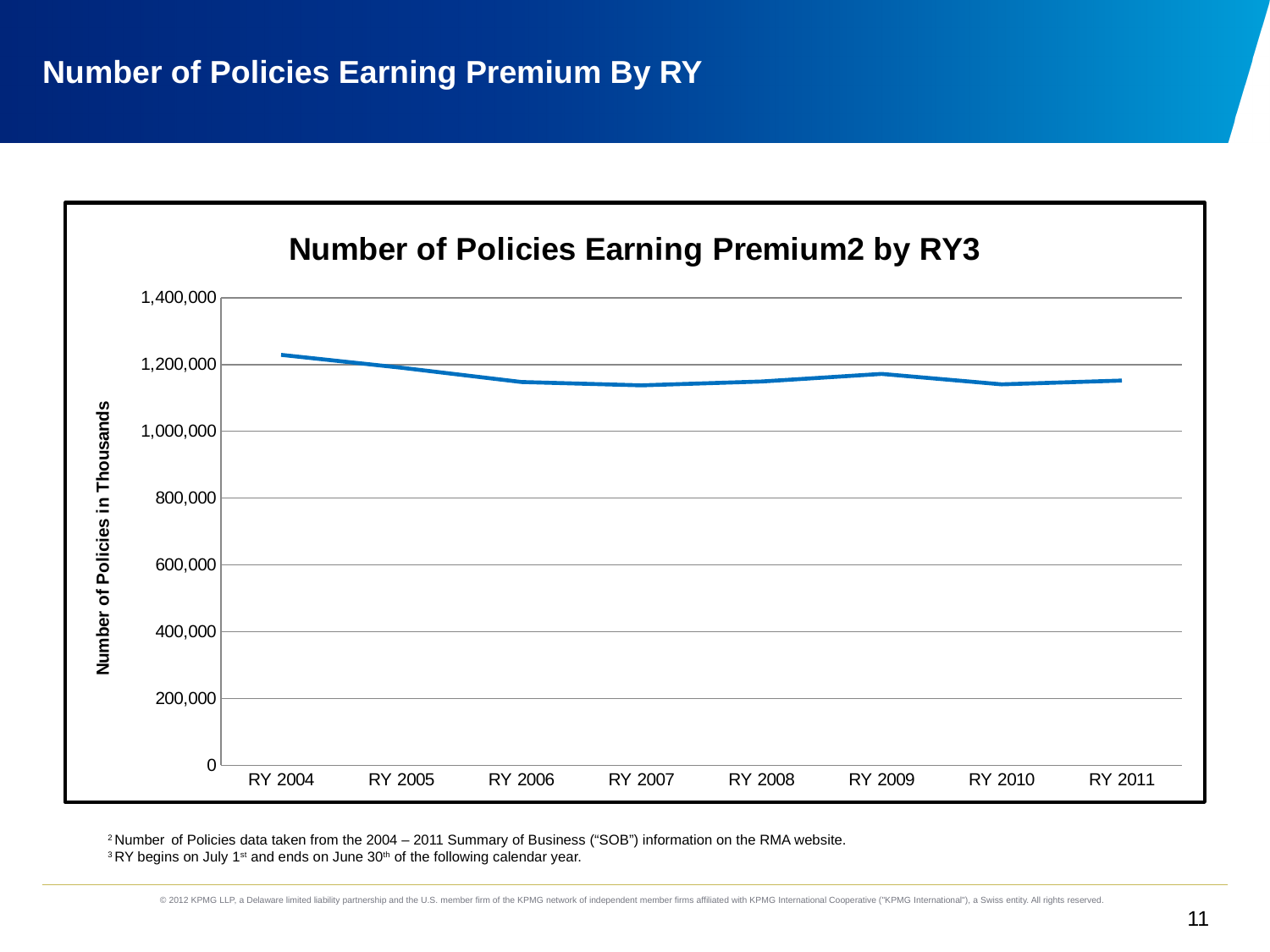
Is the value for RY 2006 greater or less than 1,200,000? less Which is larger, the value for RY 2005 or the value for RY 2007? RY 2005 Is the value for RY 2004 greater or less than 1,200,000? greater What is the label on the vertical axis of the chart? Number of Policies in Thousands Does the number of policies rise or fall from RY 2004 to RY 2007? fall What kind of chart is shown on the slide? line chart Which is larger, the value for RY 2004 or the value for RY 2009? RY 2004 How many reinsurance years (RY) are plotted on the x axis? 8 Which RY has the highest number of policies earning premium? RY 2004 What is the title of the chart? Number of Policies Earning Premium2 by RY3 Is the value for RY 2011 greater or less than 1,200,000? less